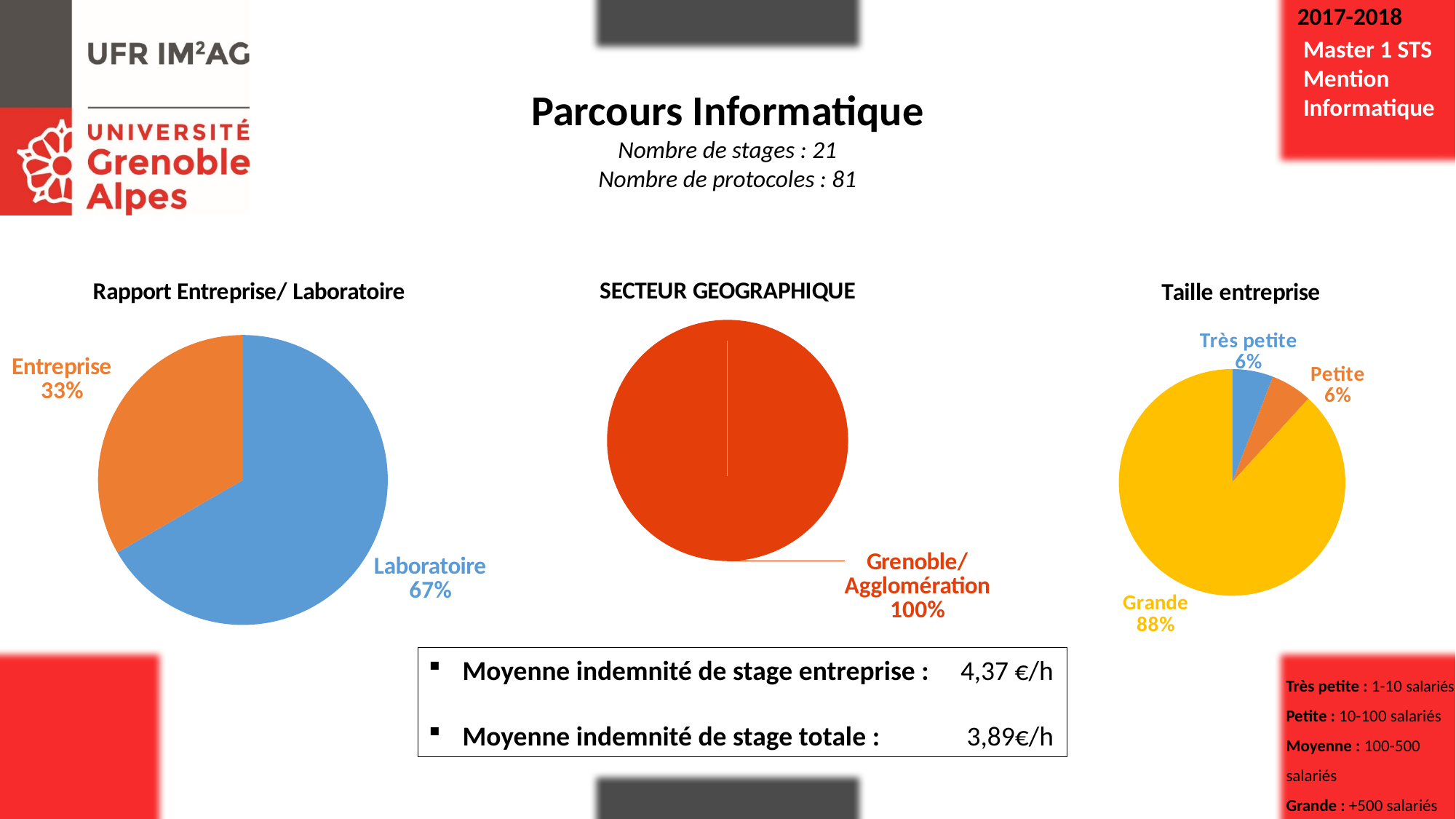
In the 'Taille entreprise' chart, what share of the pie is Très petite? 6% In the 'Taille entreprise' chart, what is the difference in percentage points between Grande and Petite? 82 In the 'Taille entreprise' chart, which slice is the largest? Grande What kind of chart is the 'SECTEUR GEOGRAPHIQUE' chart? pie chart In the 'Rapport Entreprise/ Laboratoire' chart, what share of the pie is Entreprise? 33% In the 'SECTEUR GEOGRAPHIQUE' chart, what share does Grenoble/Agglomération have? 100% In the 'Rapport Entreprise/ Laboratoire' chart, which slice is the largest? Laboratoire In the 'Rapport Entreprise/ Laboratoire' chart, what is the difference in percentage points between Laboratoire and Entreprise? 34 How many categories are shown in the 'SECTEUR GEOGRAPHIQUE' chart? 1 How many categories are shown in the 'Taille entreprise' chart? 3